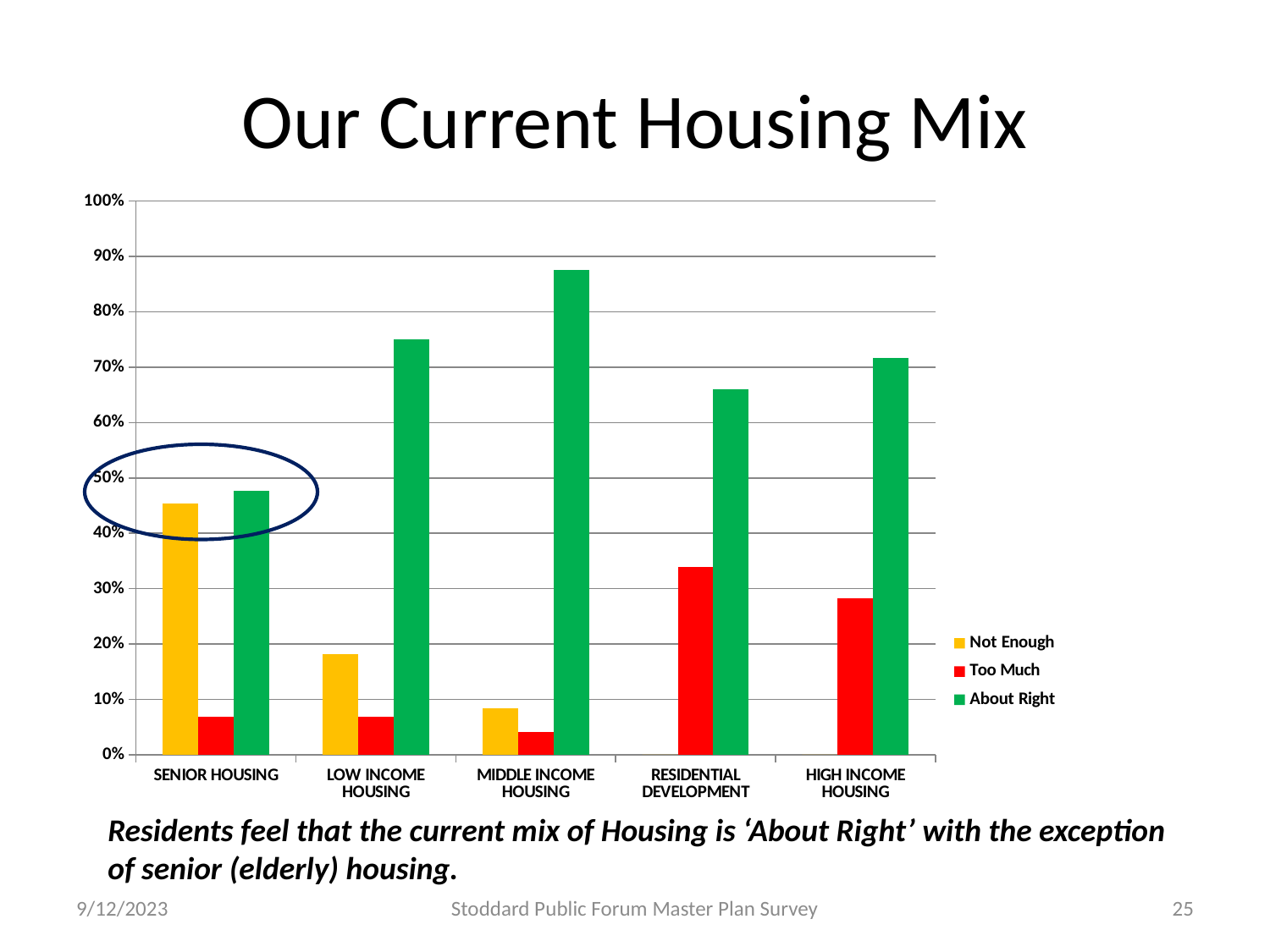
How many housing categories are shown on the x axis? 5 Is the 'About Right' value for Low Income Housing greater or less than 70%? greater What kind of chart is shown on the slide? Bar chart Is the 'Too Much' value for Residential Development greater or less than 30%? greater Which category has the highest 'Too Much' value? Residential Development Which category has the highest 'About Right' value? Middle Income Housing How many series does the legend list? 3 Which category has the lowest 'About Right' value? Senior Housing Which category has the highest 'Not Enough' value? Senior Housing Which is larger: the 'Too Much' value for Residential Development or for High Income Housing? Residential Development What colour represents the 'About Right' series in the legend? Green Is the 'Not Enough' value for Senior Housing greater or less than 40%? greater